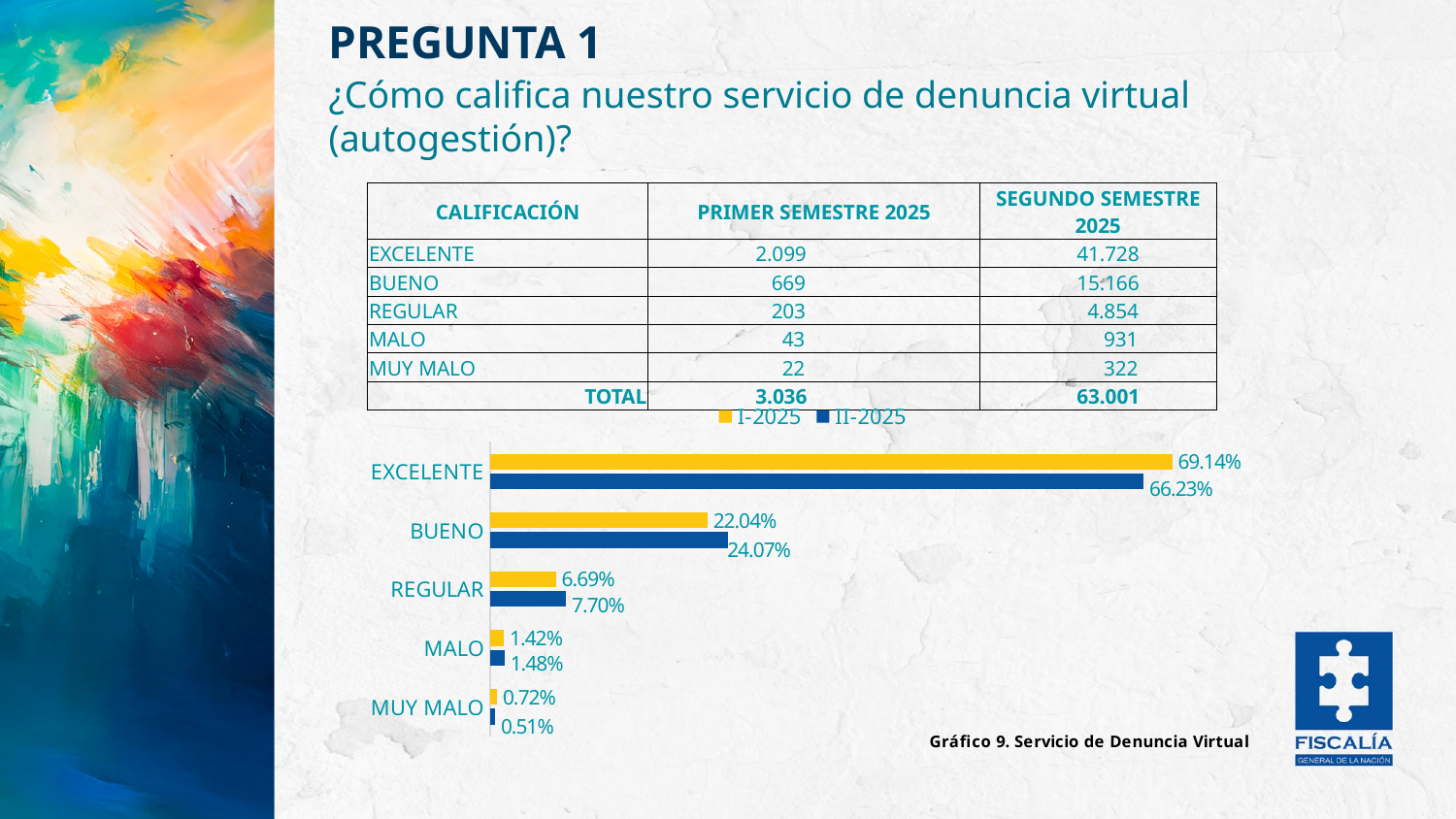
What is the value for REGULAR in the I-2025 series? 6.69% How many categories are shown on the chart? 5 Which category has the highest value in the II-2025 series? EXCELENTE What is the value for BUENO in the II-2025 series? 24.07% What is the difference between the I-2025 and II-2025 values for EXCELENTE? 2.91% Which category has the lowest value in the I-2025 series? MUY MALO For BUENO, which series has the larger value, I-2025 or II-2025? II-2025 How many series does the chart legend list? 2 What is the value for MUY MALO in the II-2025 series? 0.51% What type of chart is shown on the slide? bar chart What is the value for EXCELENTE in the I-2025 series? 69.14% Which colour represents the II-2025 series in the chart? blue